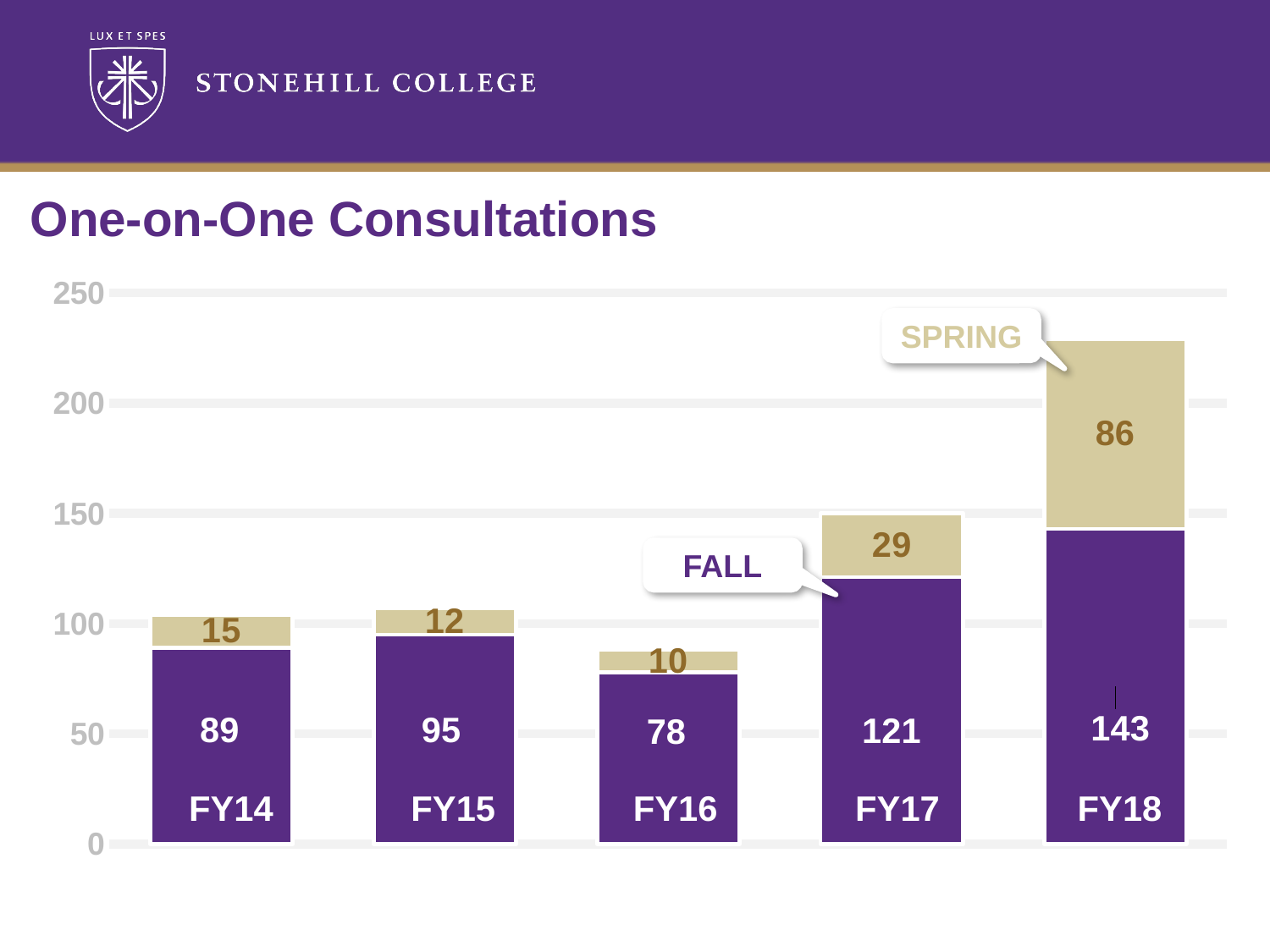
Which fiscal year has the lowest Spring value? FY16 What is the Fall value for FY17? 121 What is the total of the stacked bar for FY18? 229 Which series is shown in the tan (lighter) segments at the top of each bar? SPRING What is the total of the stacked bar for FY17? 150 What is the Spring value for FY16? 10 Which is larger, the Fall value for FY14 or the Fall value for FY15? FY15 Which fiscal year has the highest Fall value? FY18 How many fiscal years are shown on the x axis? 5 What is the Spring value for FY18? 86 What kind of chart is shown on the slide? Stacked bar chart What is the difference between the Fall values for FY18 and FY17? 22